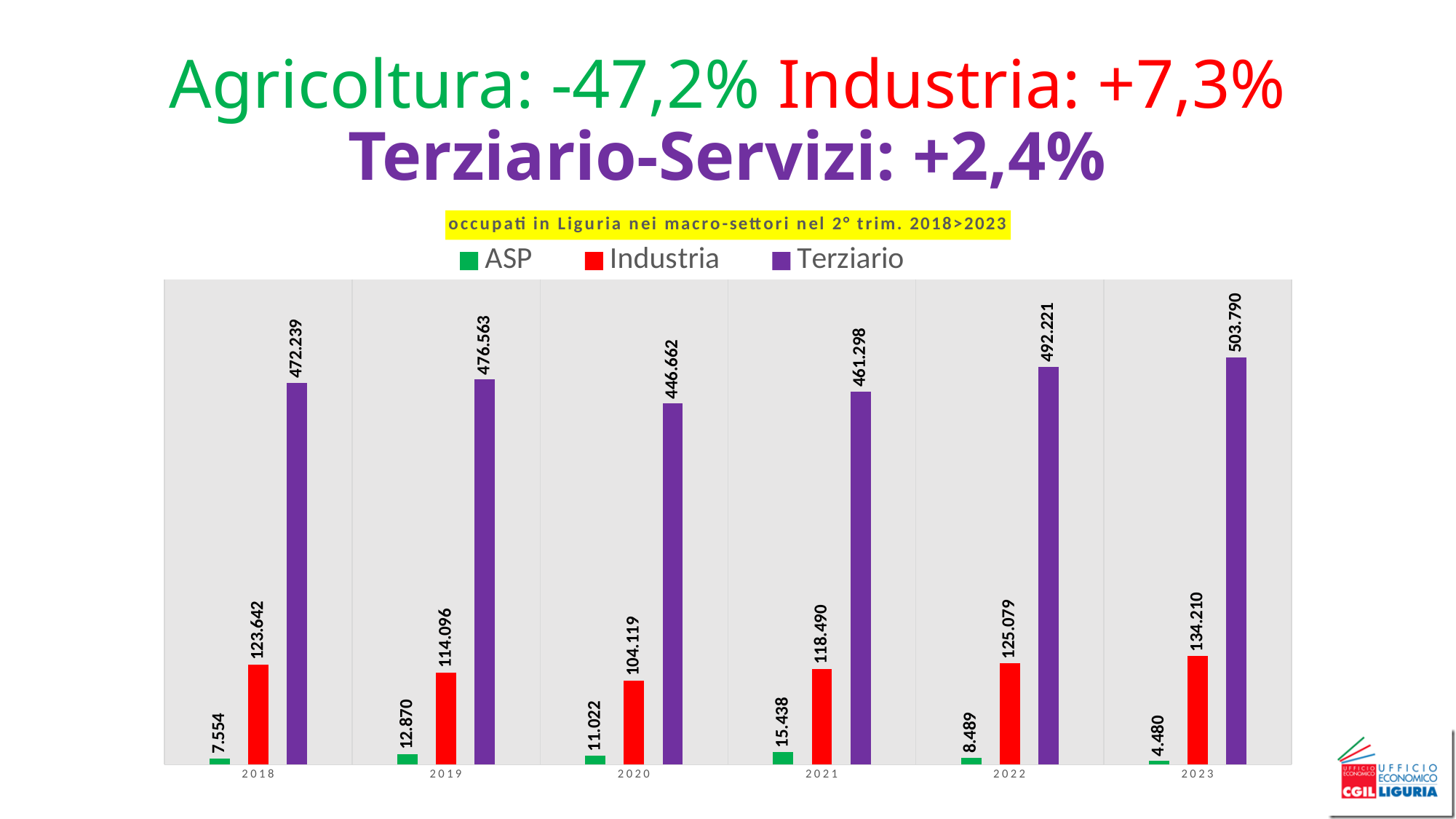
In which year is the Terziario value lowest? 2020 In which year is the ASP value highest? 2021 What is the difference between the Industria values for 2023 and 2020? 30.091 What is the ASP value for 2018? 7.554 What is the Terziario value for 2023? 503.790 What is the difference between the Terziario values for 2023 and 2018? 31.551 How many years are shown on the x axis? 6 What is the Industria value for 2020? 104.119 What kind of chart is shown? bar chart Which is larger, the Industria value for 2019 or for 2021? 2021 How many series does the legend list? 3 Which colour represents the Industria series? red